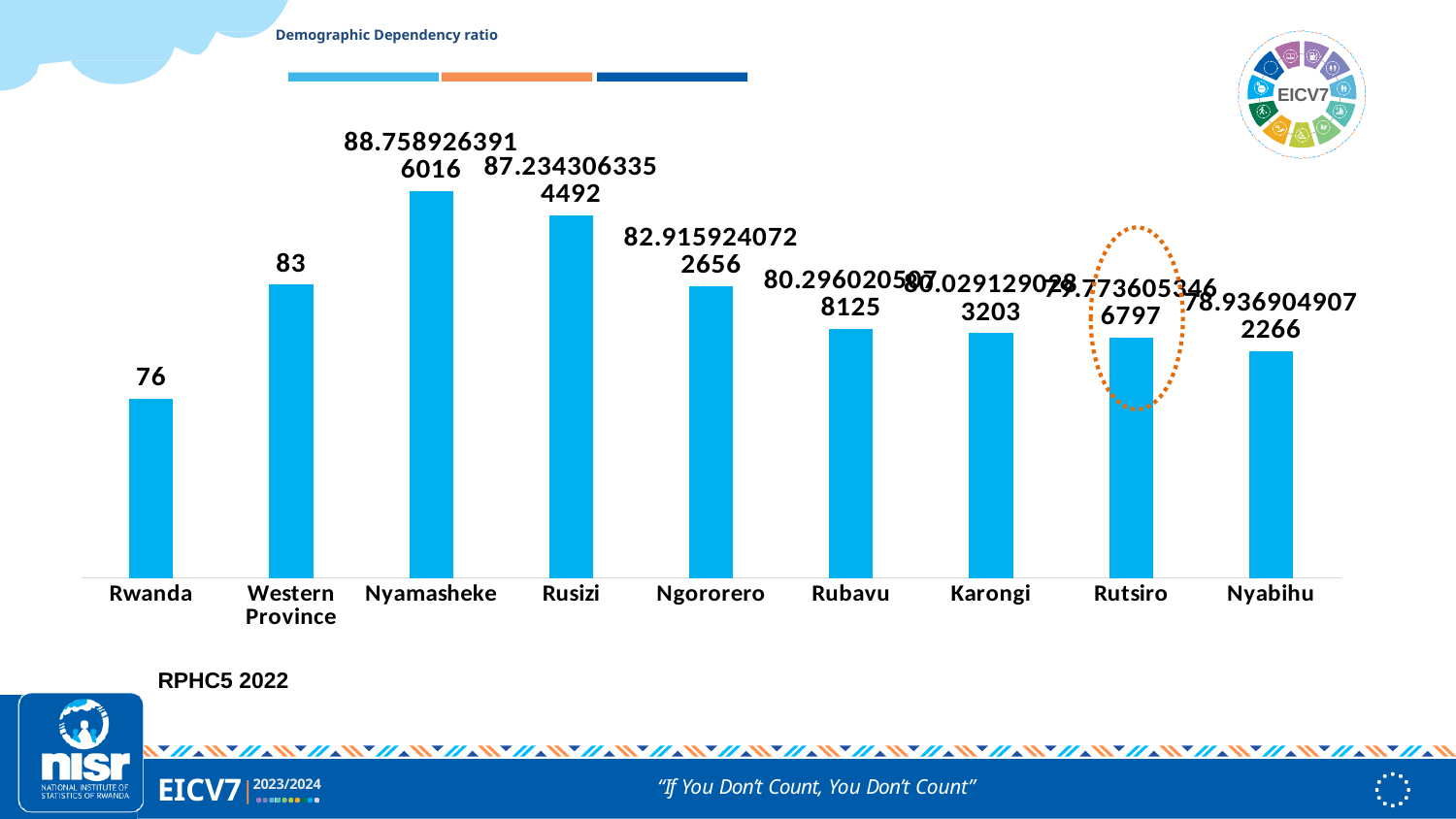
How many categories are shown on the x axis? 9 What is the value shown for Nyamasheke? 88.7589263916016 What is the difference between the values for Western Province and Rwanda? 7 What is the value for Rwanda? 76 What is the value shown for Nyabihu? 78.9369049072266 Which category has the lowest value? Rwanda Which is larger, the value for Nyamasheke or the value for Rusizi? Nyamasheke Which category's bar is highlighted with a dotted orange circle? Rutsiro What is the value shown for Rusizi? 87.2343063354492 What kind of chart is shown on the slide? Bar chart Which category has the highest value? Nyamasheke What is the value for Western Province? 83